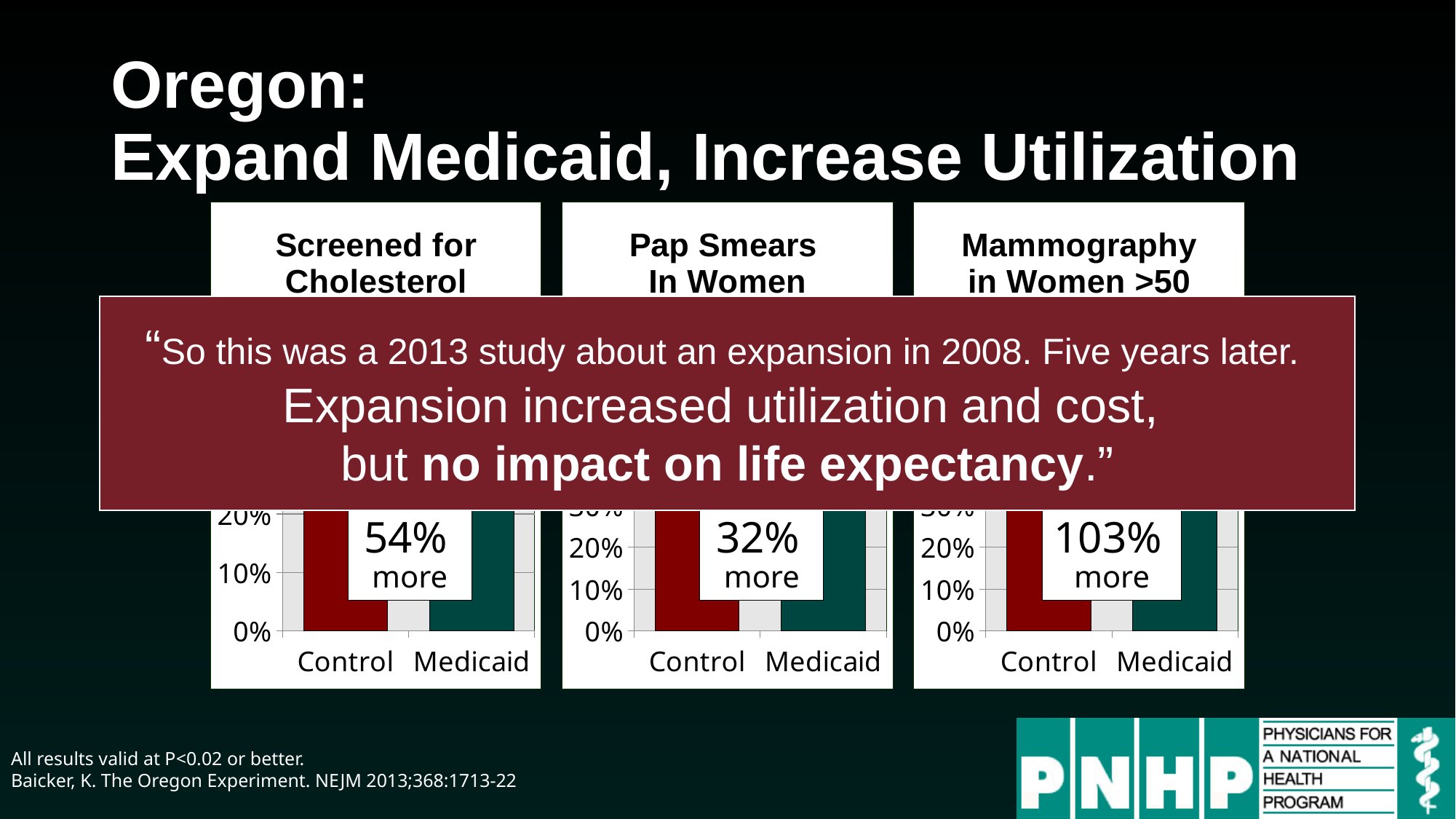
How many charts are shown on the slide? 3 In the 'Screened for Cholesterol' chart, how much more is the Medicaid group than the Control group according to the label? 54% more In the 'Mammography in Women >50' chart, is the value for Medicaid greater or less than 20%? greater Which of the three charts shows the largest percentage increase for Medicaid over Control? Mammography in Women >50 How many categories does the 'Pap Smears In Women' chart show on its x axis? 2 What are the two categories on the x axis of the 'Mammography in Women >50' chart? Control and Medicaid In the 'Pap Smears In Women' chart, is the value for Control greater or less than 20%? greater What colour are the Control bars in the three charts? dark red In the 'Mammography in Women >50' chart, how much more is the Medicaid group than the Control group according to the label? 103% more In the 'Mammography in Women >50' chart, which group has the higher value, Control or Medicaid? Medicaid What kind of chart is the 'Screened for Cholesterol' chart? bar chart In the 'Pap Smears In Women' chart, how much more is the Medicaid group than the Control group according to the label? 32% more